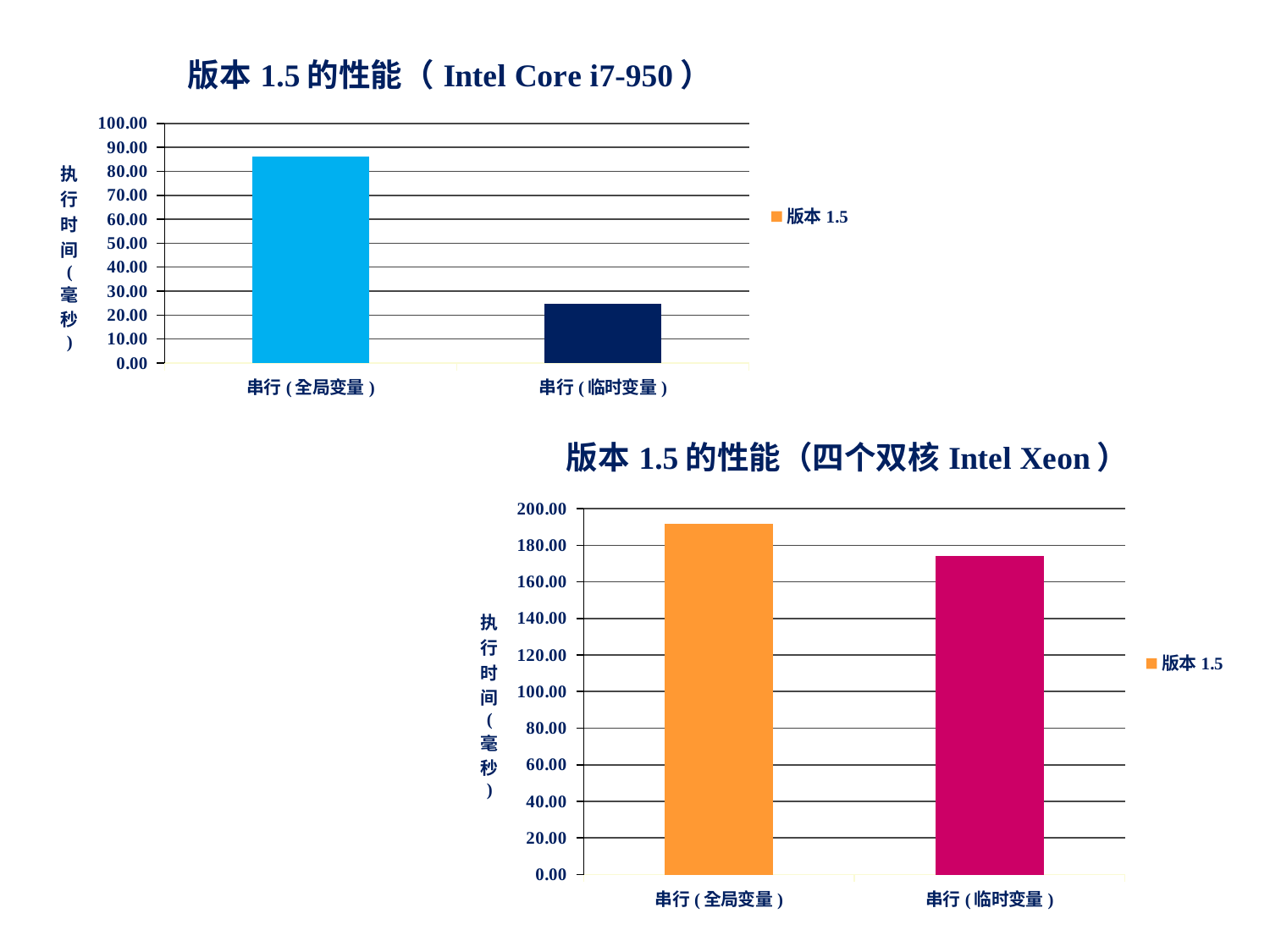
In the top chart (版本 1.5 的性能 (Intel Core i7-950)), is the value for 串行 (全局变量) greater or less than 80.00? greater In the top chart (版本 1.5 的性能 (Intel Core i7-950)), how many categories are plotted? 2 In the top chart (版本 1.5 的性能 (Intel Core i7-950)), what kind of chart is shown? bar chart In the bottom chart (版本 1.5 的性能 (四个双核 Intel Xeon)), is the value for 串行 (全局变量) greater or less than 180.00? greater In the top chart (版本 1.5 的性能 (Intel Core i7-950)), which category has the highest execution time? 串行 (全局变量) In the bottom chart (版本 1.5 的性能 (四个双核 Intel Xeon)), what is the legend entry? 版本 1.5 What is the title of the bottom chart? 版本 1.5 的性能（四个双核 Intel Xeon） In the top chart (版本 1.5 的性能 (Intel Core i7-950)), how many series does the legend list? 1 In the top chart (版本 1.5 的性能 (Intel Core i7-950)), which category has the lowest execution time? 串行 (临时变量) In the bottom chart (版本 1.5 的性能 (四个双核 Intel Xeon)), is the value for 串行 (临时变量) greater or less than 160.00? greater In the bottom chart (版本 1.5 的性能 (四个双核 Intel Xeon)), which category has the higher execution time, 串行 (全局变量) or 串行 (临时变量)? 串行 (全局变量)